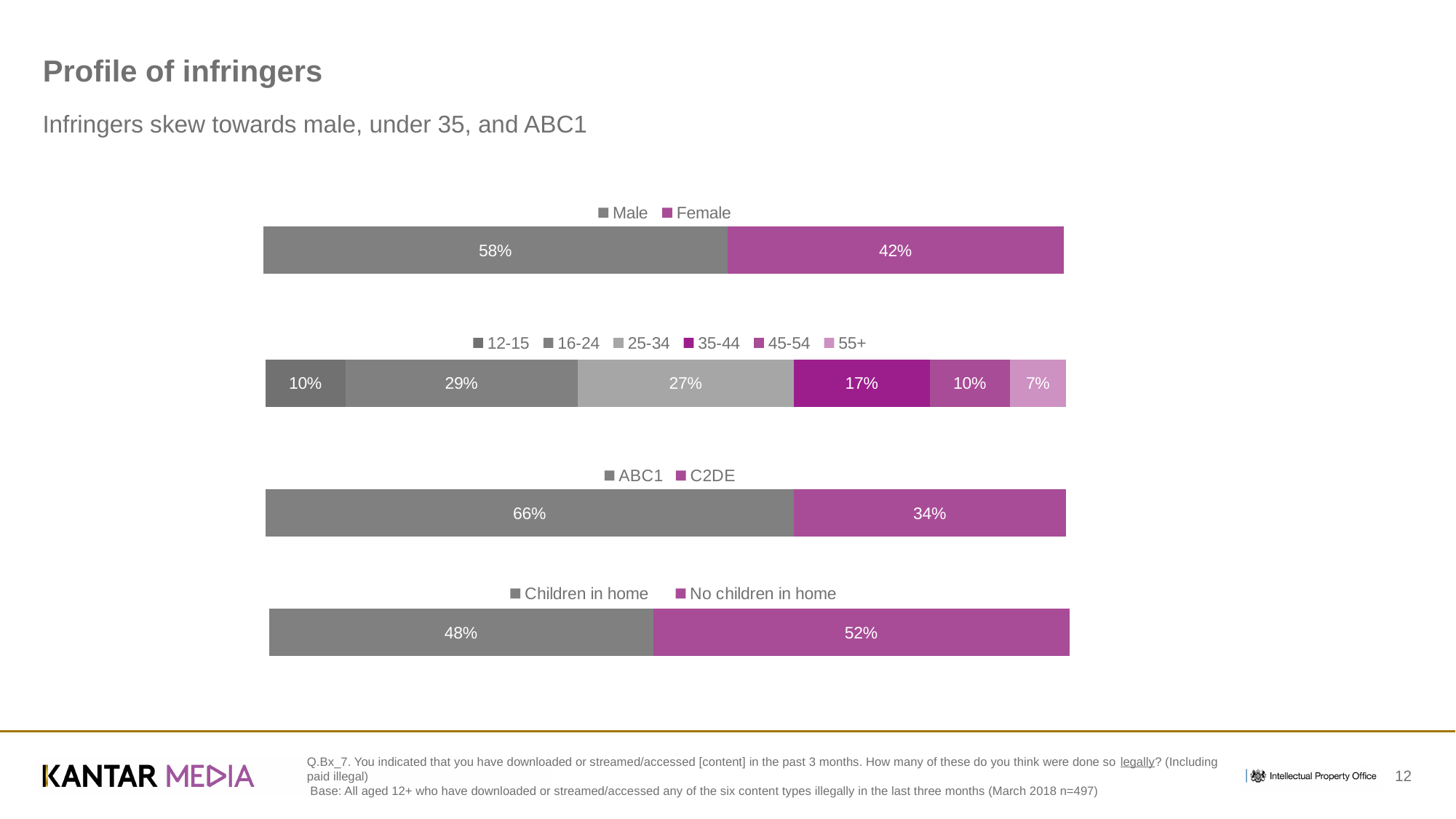
In the gender chart (top), what percentage of infringers are female? 42% In the children in home chart (bottom), what percentage of infringers have children in home? 48% In the children in home chart (bottom), which is larger: children in home or no children in home? No children in home In the age chart (second from top), how many age groups does the legend list? 6 In the age chart (second from top), what percentage of infringers are aged 16-24? 29% In the age chart (second from top), what is the difference between the 25-34 and 35-44 shares? 10% In the gender chart (top), what percentage of infringers are male? 58% In the social grade chart (third from top), what is the difference between ABC1 and C2DE? 32% In the social grade chart (third from top), what percentage of infringers are ABC1? 66% What type of chart is used for the gender chart (top)? Stacked bar chart In the age chart (second from top), which age group has the smallest share? 55+ In the age chart (second from top), which age group has the largest share? 16-24